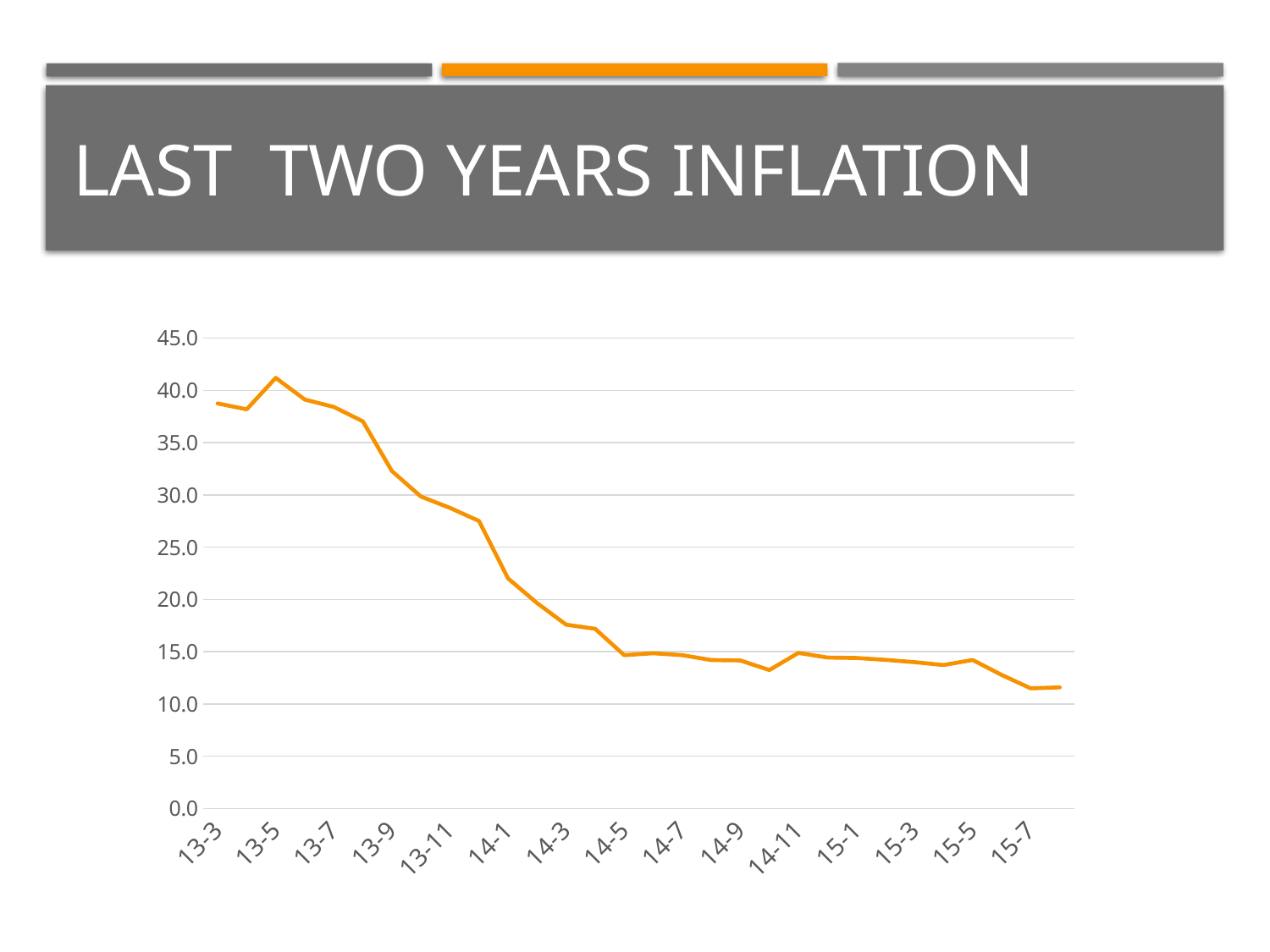
Which has the larger value, 13-9 or 14-3? 13-9 Is the value for 13-9 greater or less than 30.0? greater What is the title of the slide? LAST TWO YEARS INFLATION What is the highest value shown on the vertical axis? 45.0 Do the values generally rise or fall from 13-3 to 15-7? fall Which has the larger value, 13-3 or 15-7? 13-3 Is the value for 15-7 greater or less than 15.0? less What kind of chart is shown on the slide? line chart Is the value for 14-1 greater or less than 20.0? greater